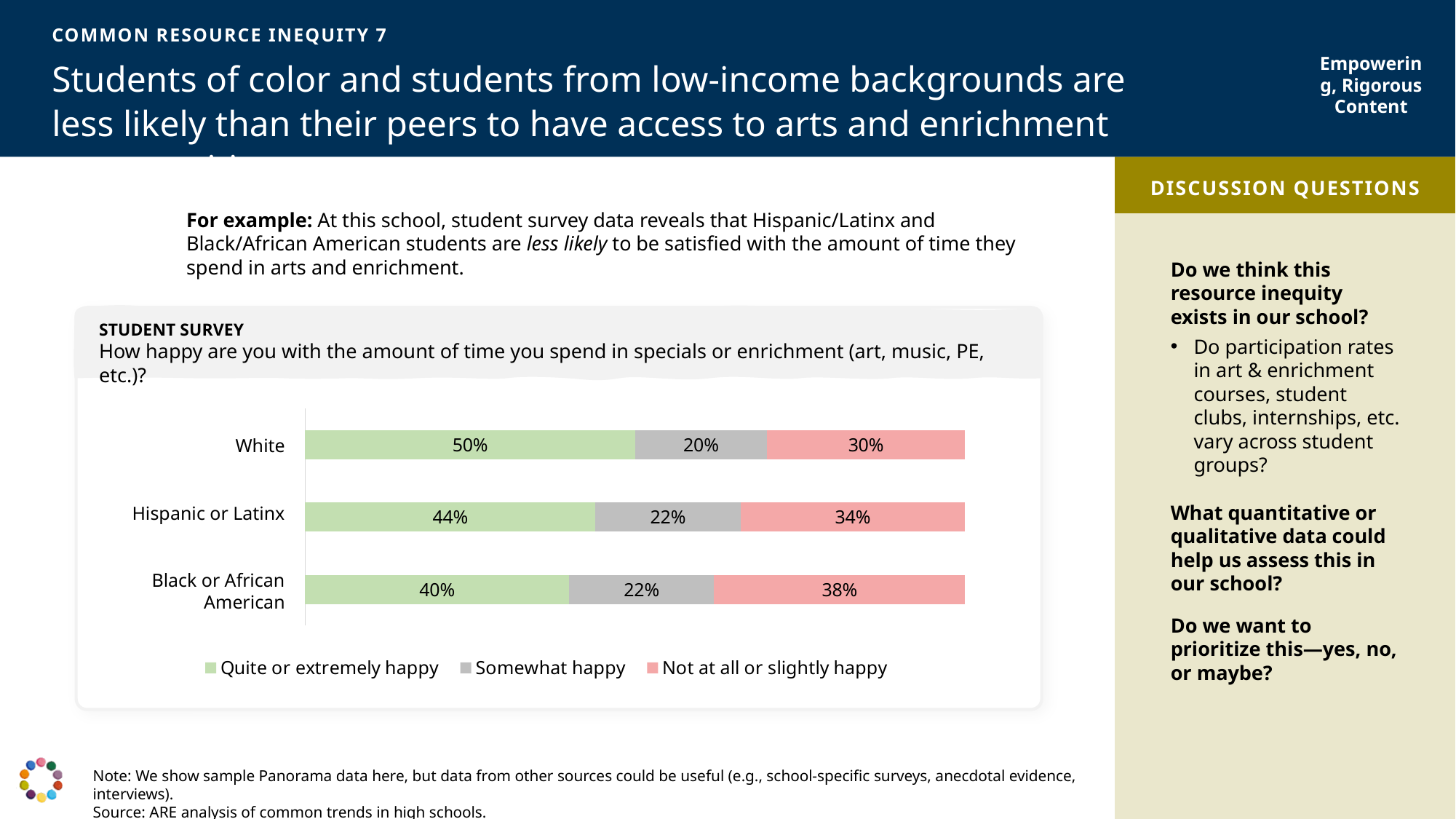
What percentage of White students are quite or extremely happy with the amount of time spent in specials or enrichment? 50% What percentage of Black or African American students are not at all or slightly happy? 38% Which colour represents the 'Not at all or slightly happy' series in the legend? Pink/red How many series does the legend list? 3 What kind of chart is shown on the slide? Stacked bar chart Which student group has the lowest share of students who are not at all or slightly happy? White Which student group has the highest share of students who are quite or extremely happy? White What is the difference between the quite or extremely happy percentages for White and Black or African American students? 10 percentage points What is the total of the three segments for the Hispanic or Latinx bar? 100% How many student groups are shown in the chart? 3 Which is larger: the not at all or slightly happy share for Hispanic or Latinx students or for Black or African American students? Black or African American What percentage of Hispanic or Latinx students are somewhat happy? 22%